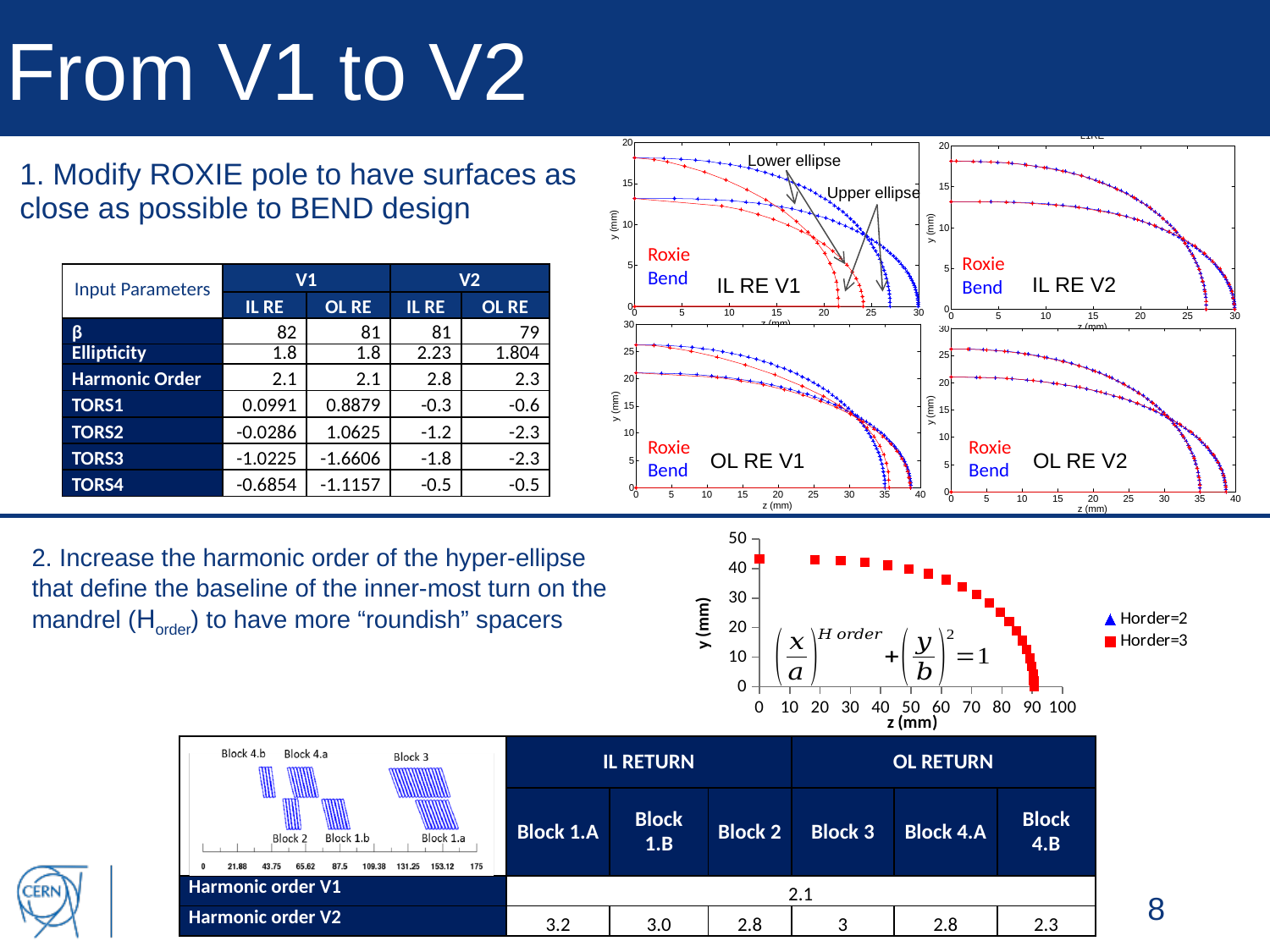
In the chart with the Horder=2 and Horder=3 legend, is the y value of the point at z = 0 greater or less than 30? greater In the chart with the Horder=2 and Horder=3 legend, what is the highest tick value shown on the vertical axis? 50 In the IL RE V1 plot, what colour is the Roxie curve? Red In the chart with the Horder=2 and Horder=3 legend, what is the highest tick value shown on the horizontal axis? 100 What kind of chart is the one with the Horder=2 and Horder=3 legend? Scatter chart In the chart with axes y (mm) and z (mm) in the middle of the slide, how many series does the legend list? 2 How many small ROXIE versus BEND comparison plots are shown in the top right of the slide? 4 In the chart with the Horder=2 and Horder=3 legend, do the y values rise or fall as z increases? Fall